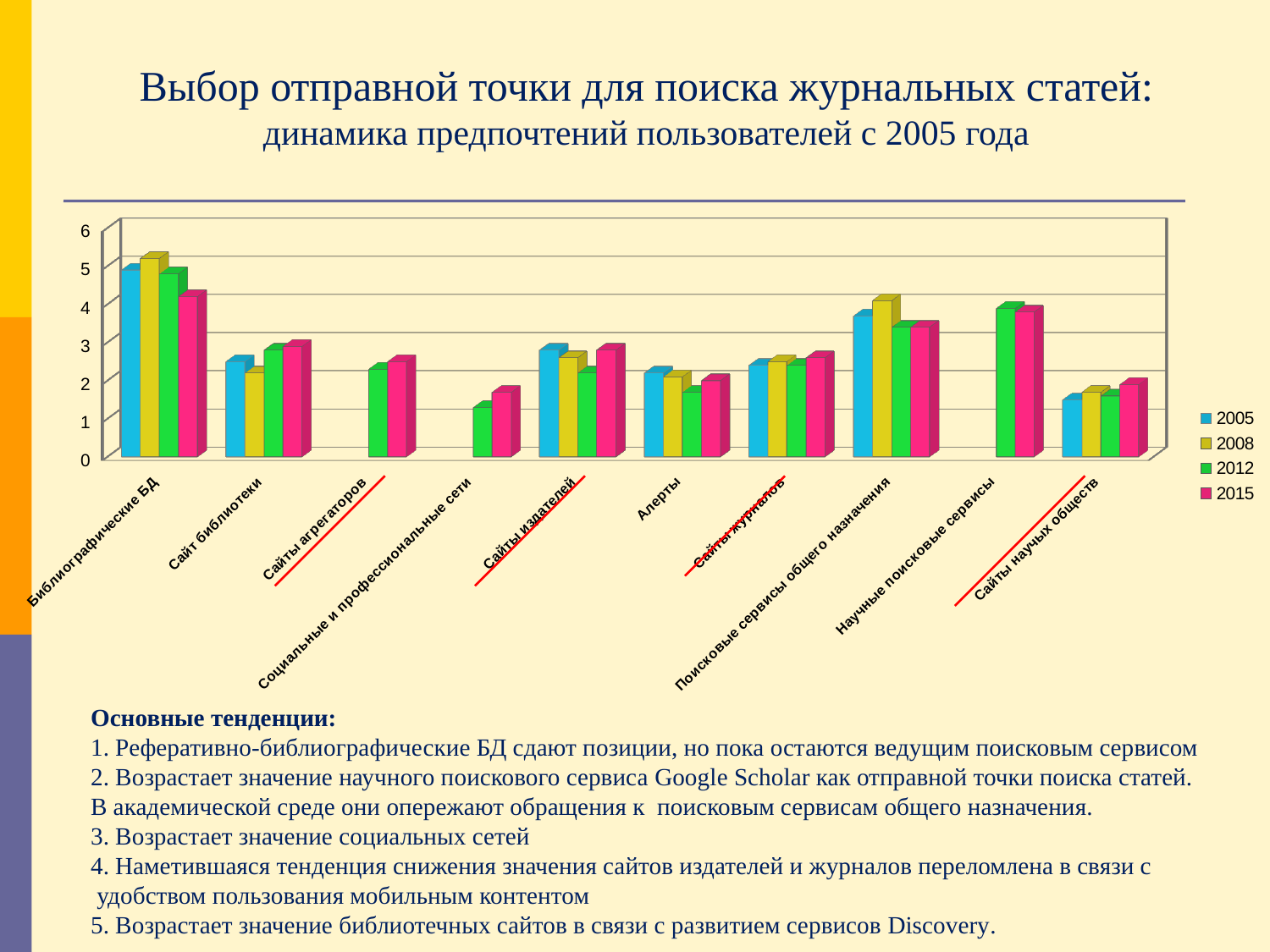
For Библиографические БД, do the values rise or fall from 2008 to 2015? fall Is the 2008 value for Поисковые сервисы общего назначения greater or less than 4? greater Is the 2012 value for Социальные и профессиональные сети greater or less than 2? less What kind of chart is shown on the slide? Bar chart Which category has the highest value for the 2015 series? Библиографические БД How many series does the legend list? 4 Which years are listed in the chart legend? 2005, 2008, 2012, 2015 Which is larger for Алерты: the 2005 value or the 2012 value? 2005 How many categories are shown along the x axis of the chart? 10 Which category has the highest value for the 2008 series? Библиографические БД Is the 2008 value for Библиографические БД greater or less than 5? greater Which is larger for Сайт библиотеки: the 2005 value or the 2015 value? 2015